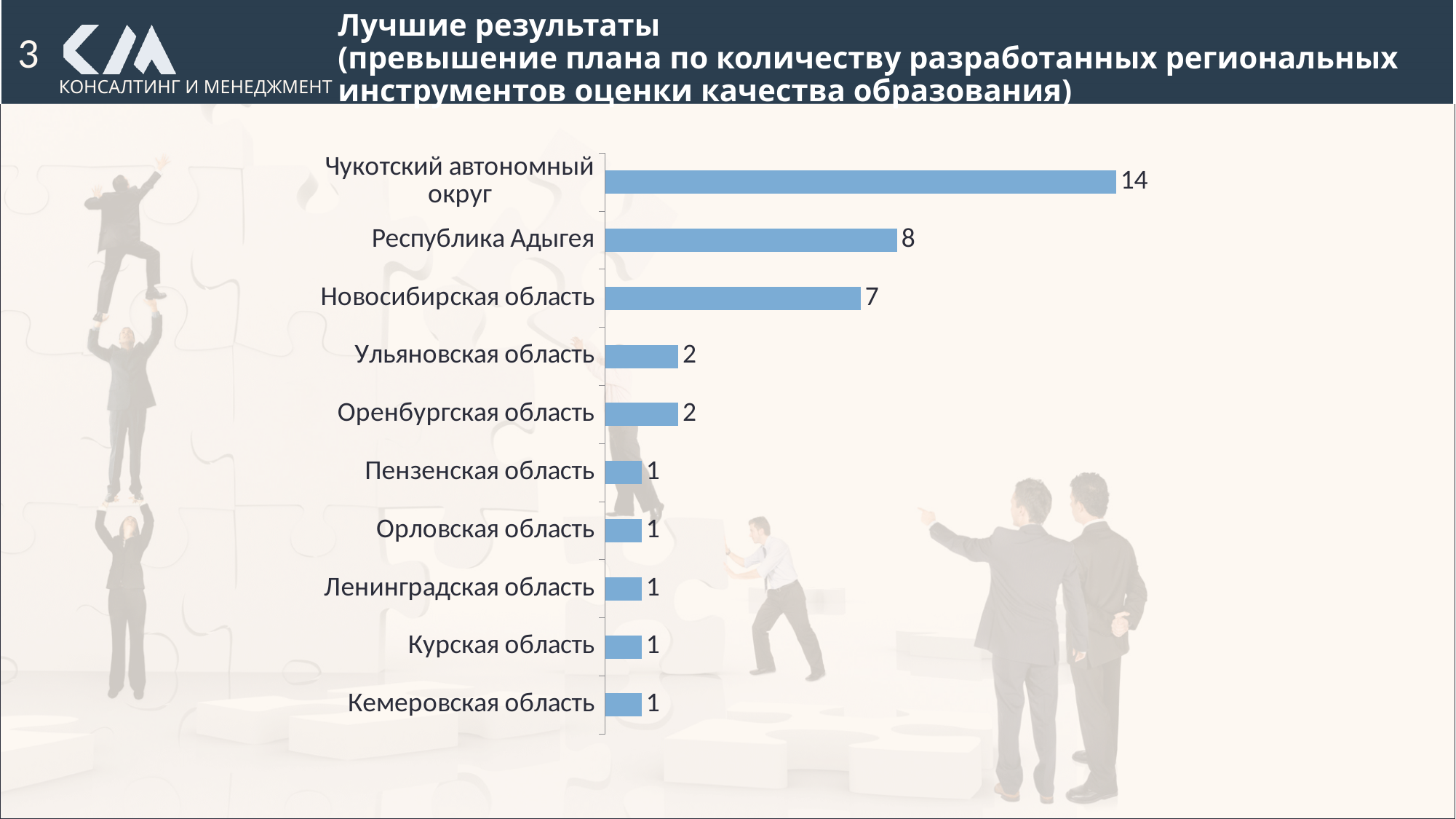
What is the value for Республика Адыгея? 8 What is the difference between the values for Новосибирская область and Оренбургская область? 5 What is the value for Чукотский автономный округ? 14 What is the value for Новосибирская область? 7 How many categories have a value of 1? 5 How many categories are shown in the chart? 10 What is the value for Ульяновская область? 2 What kind of chart is shown on the slide? Bar chart What is the difference between the values for Чукотский автономный округ and Республика Адыгея? 6 What is the value for Кемеровская область? 1 Which category has the highest value? Чукотский автономный округ Which is larger, the value for Республика Адыгея or the value for Новосибирская область? Республика Адыгея